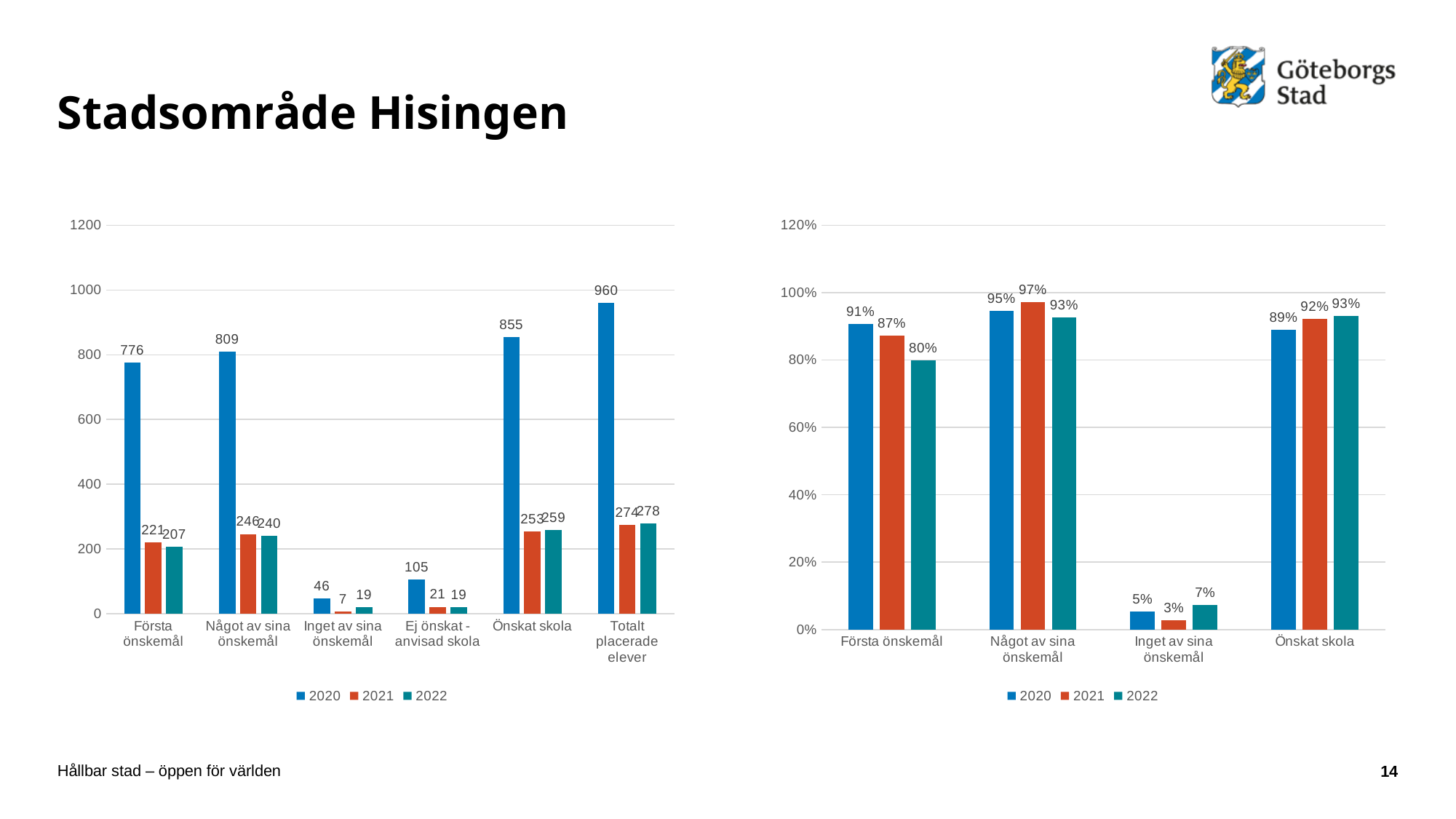
On the right chart, what is the difference between the 2021 and 2020 values for Något av sina önskemål? 2% On the left chart, what is the difference between the 2020 and 2021 values for Första önskemål? 555 On the right chart, which category has the lowest value for 2021? Inget av sina önskemål How many series does the legend of the right chart list? 3 On the left chart, what is the value for 2020 for Totalt placerade elever? 960 On the left chart, which category has the highest value for 2020? Totalt placerade elever On the left chart, what is the value for 2021 for Inget av sina önskemål? 7 On the right chart, which is larger for Önskat skola: the 2020 value or the 2022 value? 2022 How many categories are shown on the left chart? 6 On the right chart, do the values for Första önskemål rise or fall from 2020 to 2022? fall On the right chart, what is the value for 2022 for Första önskemål? 80% What kind of chart is the right chart? bar chart